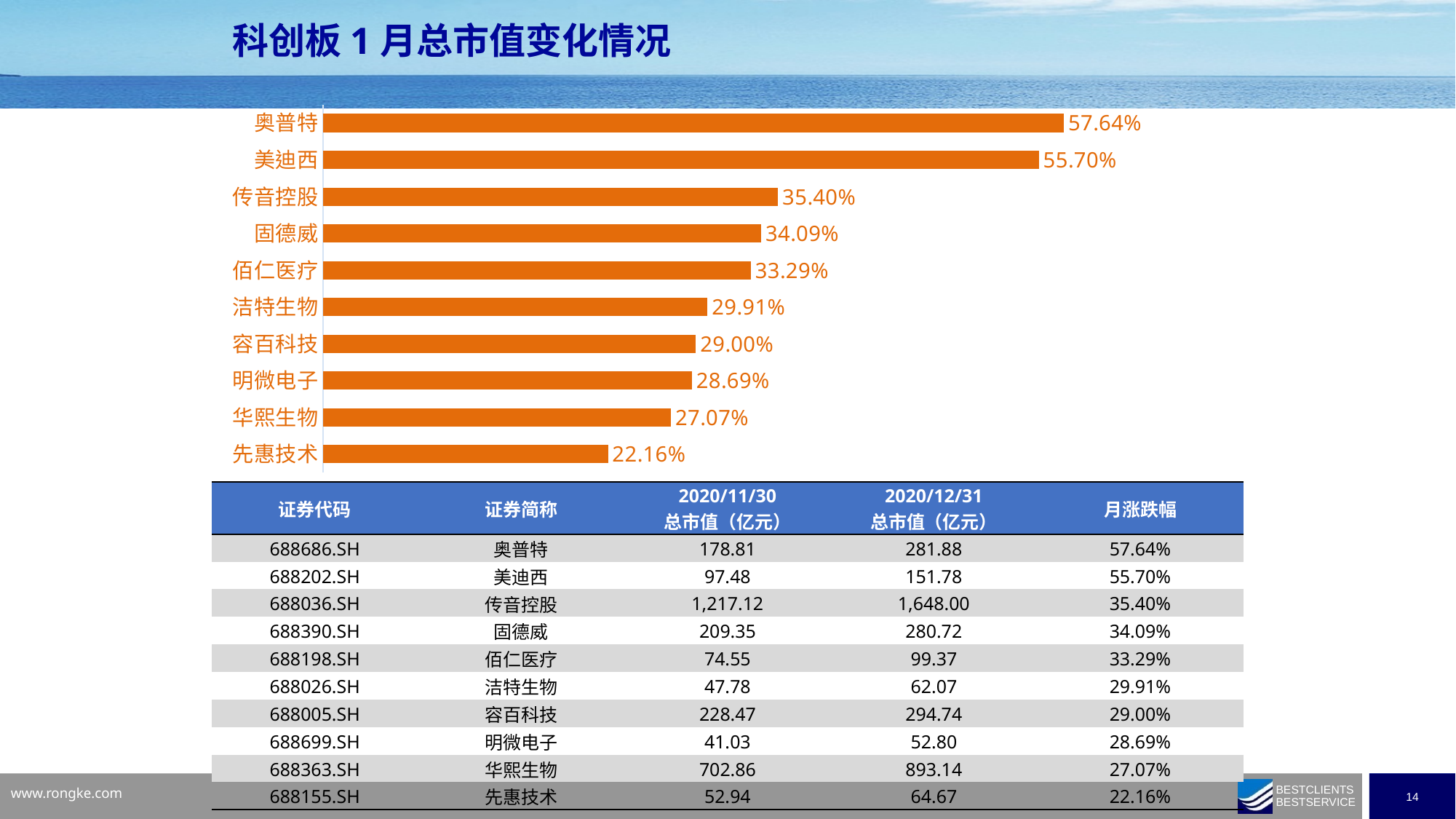
What is the value shown for 奥普特 in the bar chart? 57.64% What is the value shown for 洁特生物 in the bar chart? 29.91% What colour are the bars in the chart? Orange What is the difference between the values for 传音控股 and 先惠技术 in the bar chart? 13.24% What kind of chart is shown on the slide? Bar chart Which has a larger value in the bar chart, 华熙生物 or 明微电子? 明微电子 Which category has the lowest value in the bar chart? 先惠技术 Which has a larger value in the bar chart, 固德威 or 佰仁医疗? 固德威 Which category has the highest value in the bar chart? 奥普特 What is the value shown for 先惠技术 in the bar chart? 22.16% What is the difference between the values for 奥普特 and 美迪西 in the bar chart? 1.94% How many categories are shown in the bar chart? 10